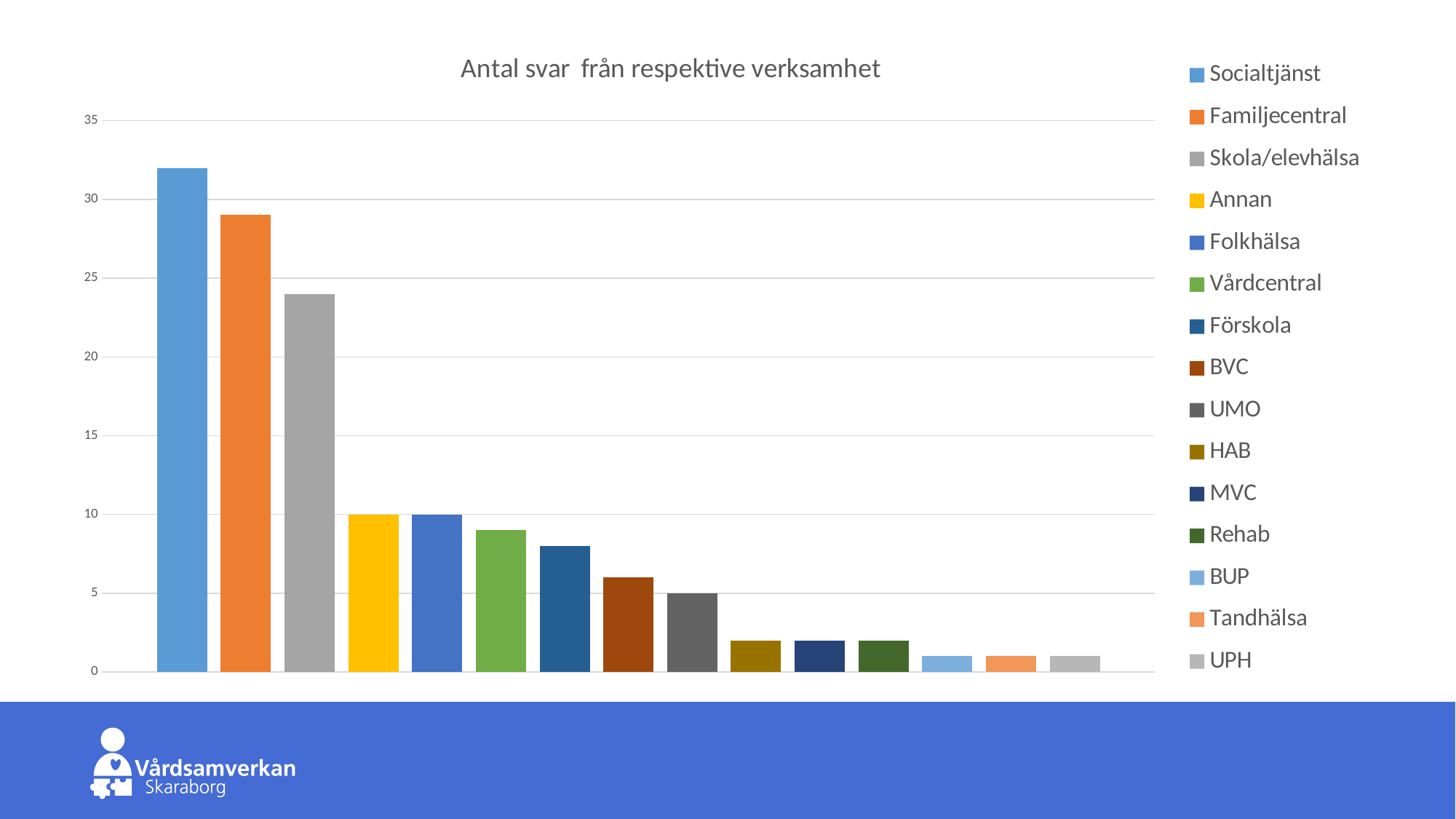
Is the value for Socialtjänst greater or less than 30? greater What is the value for Annan? 10 What kind of chart is shown on the slide? bar chart How many bars are plotted in the chart? 15 Do the bar values rise or fall from left to right across the chart? fall How many entries does the legend list? 15 Which category has the highest value? Socialtjänst What is the title of the chart? Antal svar från respektive verksamhet What is the value for UMO? 5 Is the value for HAB greater or less than 5? less Is the value for Skola/elevhälsa greater or less than 25? less Which is larger, the value for Familjecentral or the value for Skola/elevhälsa? Familjecentral